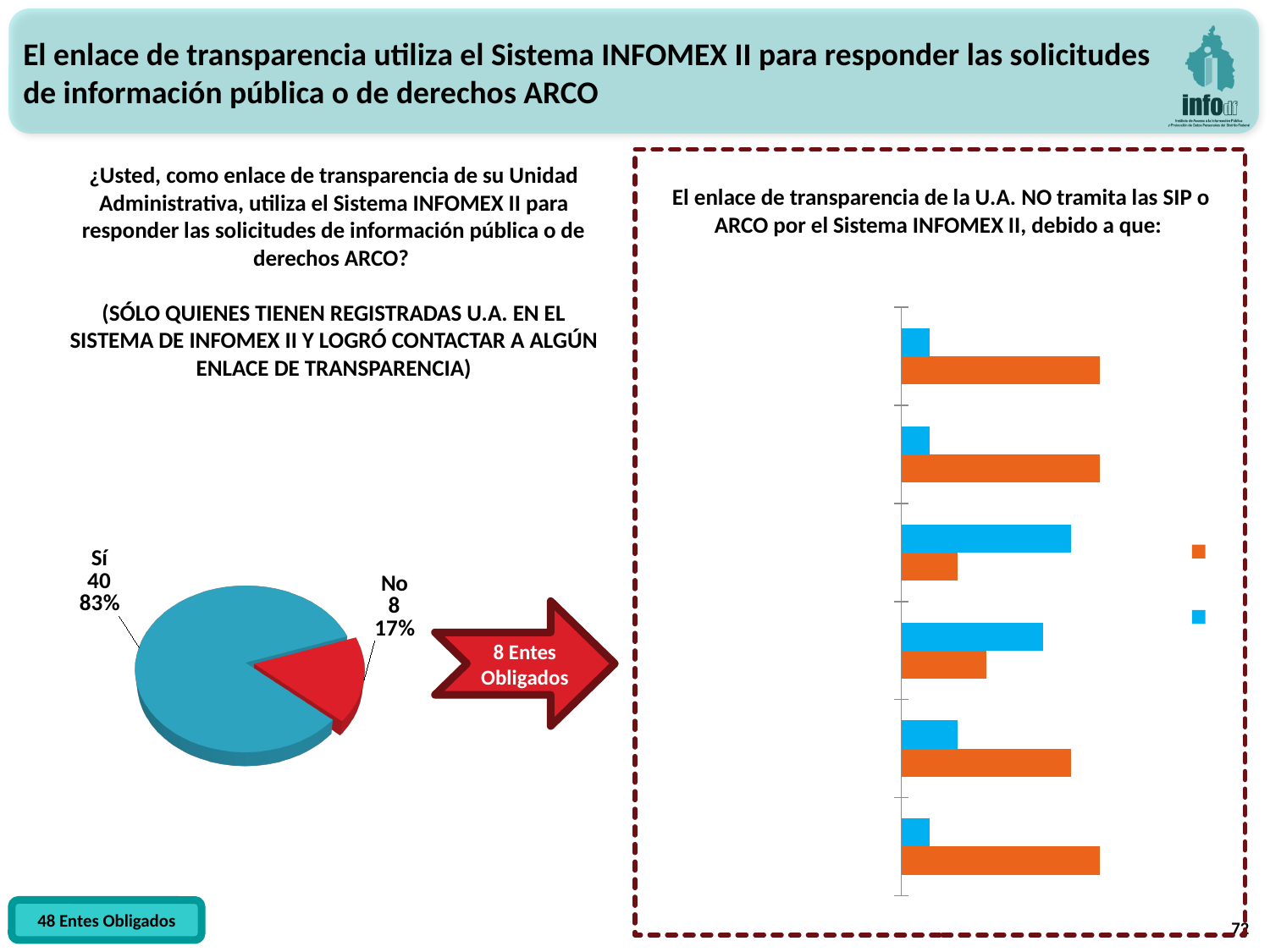
On the pie chart on the left, what is the difference between the number of "Sí" and "No" responses? 32 On the pie chart on the left, how many respondents answered "No"? 8 On the pie chart on the left, what percentage share does the "Sí" slice represent? 83% On the pie chart on the left, how many slices does the chart have? 2 On the bar chart on the right, how many colour entries does the legend show? 2 What kind of chart is shown on the left side of the slide? Pie chart On the pie chart on the left, what is the total number of responses across both slices? 48 On the pie chart on the left, what percentage share does the "No" slice represent? 17% On the pie chart on the left, how many respondents answered "Sí"? 40 What kind of chart is shown inside the dashed box on the right side of the slide? Bar chart On the pie chart on the left, which category has the larger slice? Sí On the pie chart on the left, which category has the smaller slice? No